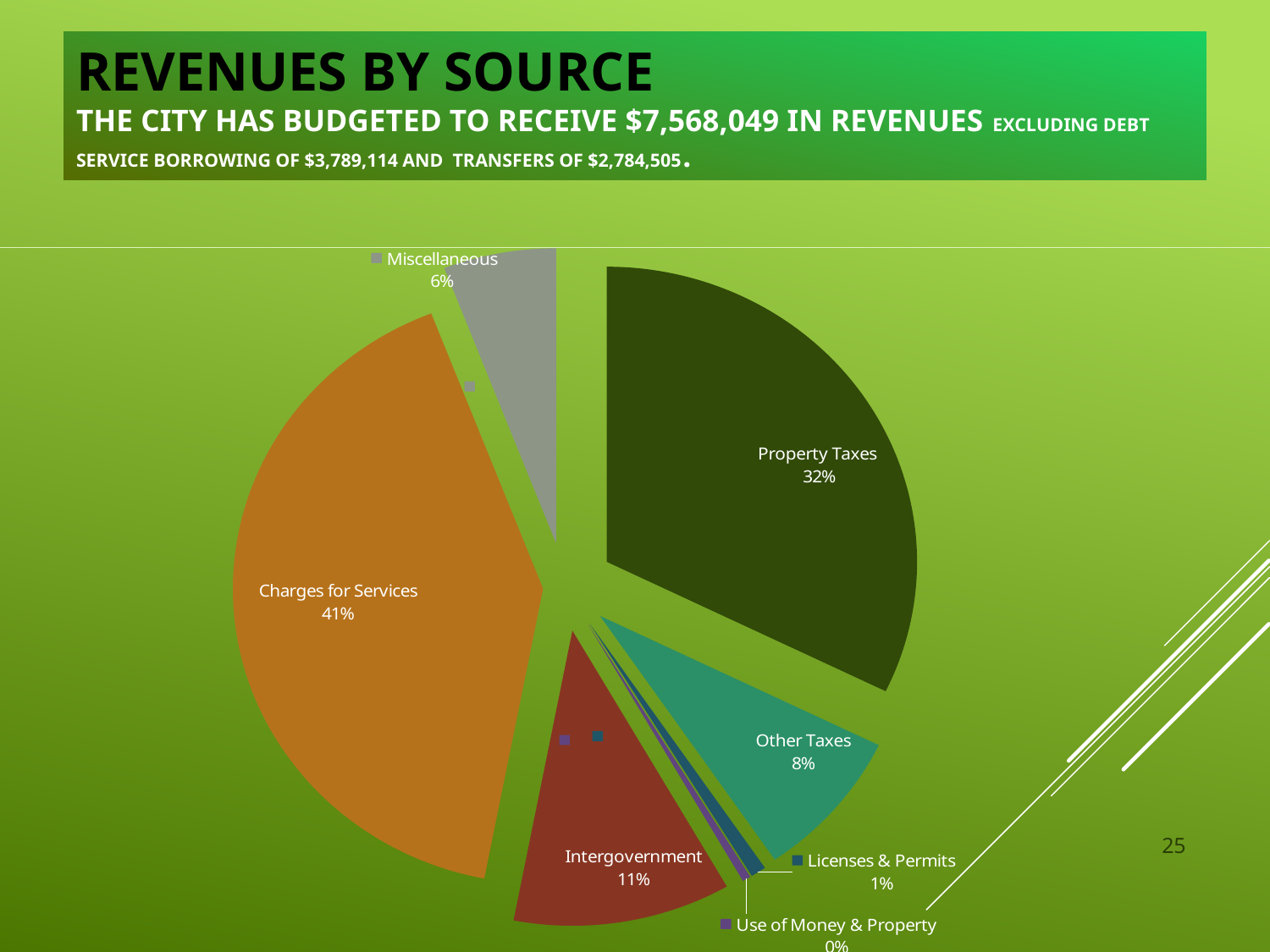
What percentage of revenues is Other Taxes? 8% What share of revenues comes from Charges for Services? 41% Which is larger, the share for Property Taxes or the share for Intergovernment? Property Taxes How many percentage points larger is Charges for Services than Property Taxes? 9 What kind of chart is shown on the slide? Pie chart What share of revenues comes from Property Taxes? 32% What percentage of revenues comes from Licenses & Permits? 1% What percentage is shown for Use of Money & Property? 0% Which revenue source has the largest share of the pie? Charges for Services What percentage of revenues is Intergovernment? 11% What share of revenues is Miscellaneous? 6% What is the title of the slide containing the chart? Revenues by Source